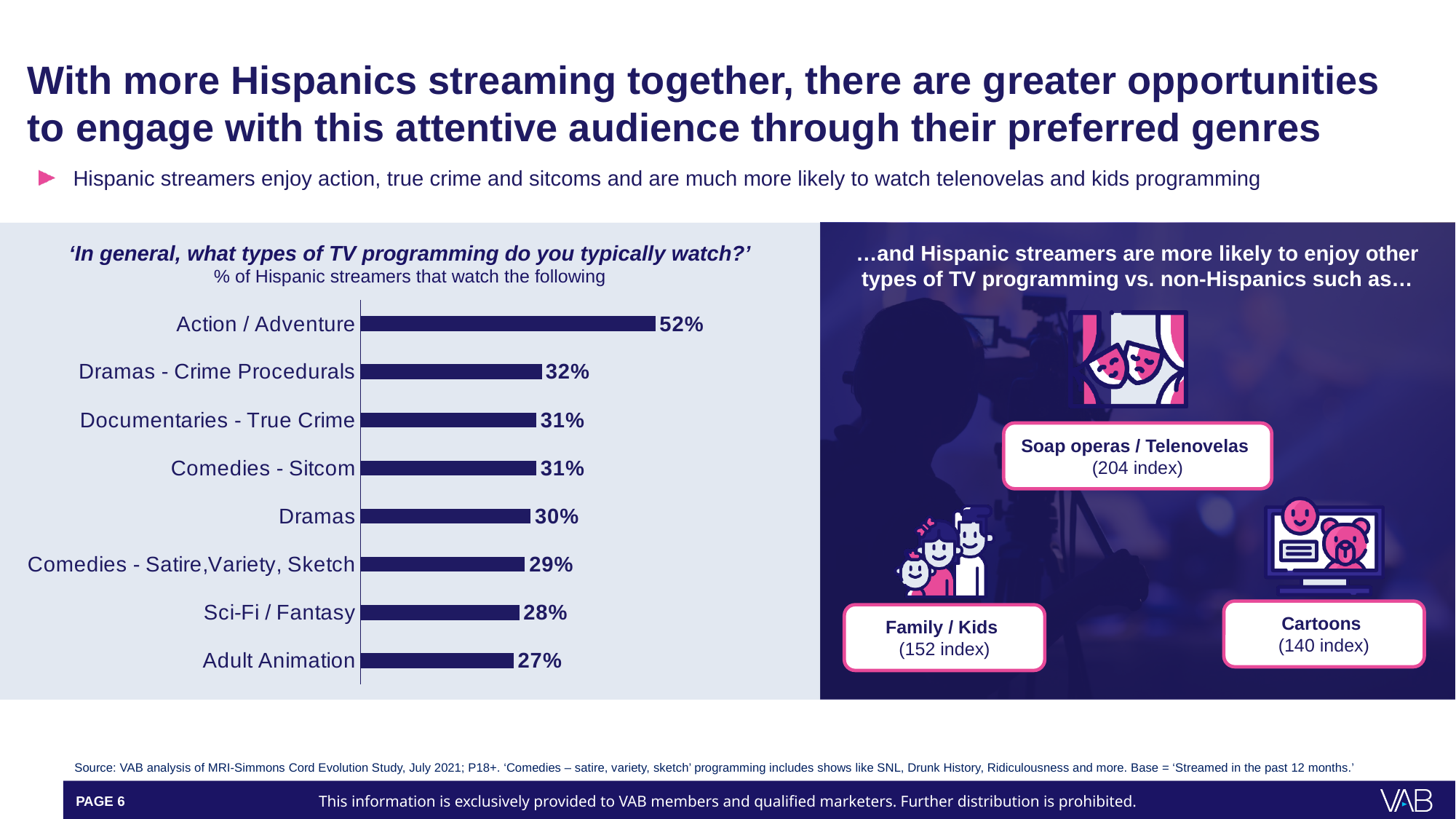
Which type of TV programming has the highest percentage of Hispanic streamers watching it? Action / Adventure What percentage of Hispanic streamers watch Adult Animation? 27% Which type of TV programming has the lowest percentage of Hispanic streamers watching it? Adult Animation What is the subtitle of the bar chart, shown below the survey question? % of Hispanic streamers that watch the following How many types of TV programming are shown in the bar chart? 8 What is the difference in percentage points between Action / Adventure and Dramas - Crime Procedurals? 20 What kind of chart is used to show the percentage of Hispanic streamers watching each type of programming? Bar chart What percentage of Hispanic streamers watch Action / Adventure programming? 52% Do the values in the bar chart increase or decrease from top to bottom? Decrease What percentage of Hispanic streamers watch Sci-Fi / Fantasy? 28% Which has a higher percentage of Hispanic streamers watching: Dramas - Crime Procedurals or Comedies - Satire,Variety, Sketch? Dramas - Crime Procedurals What is the difference in percentage points between Dramas and Adult Animation? 3